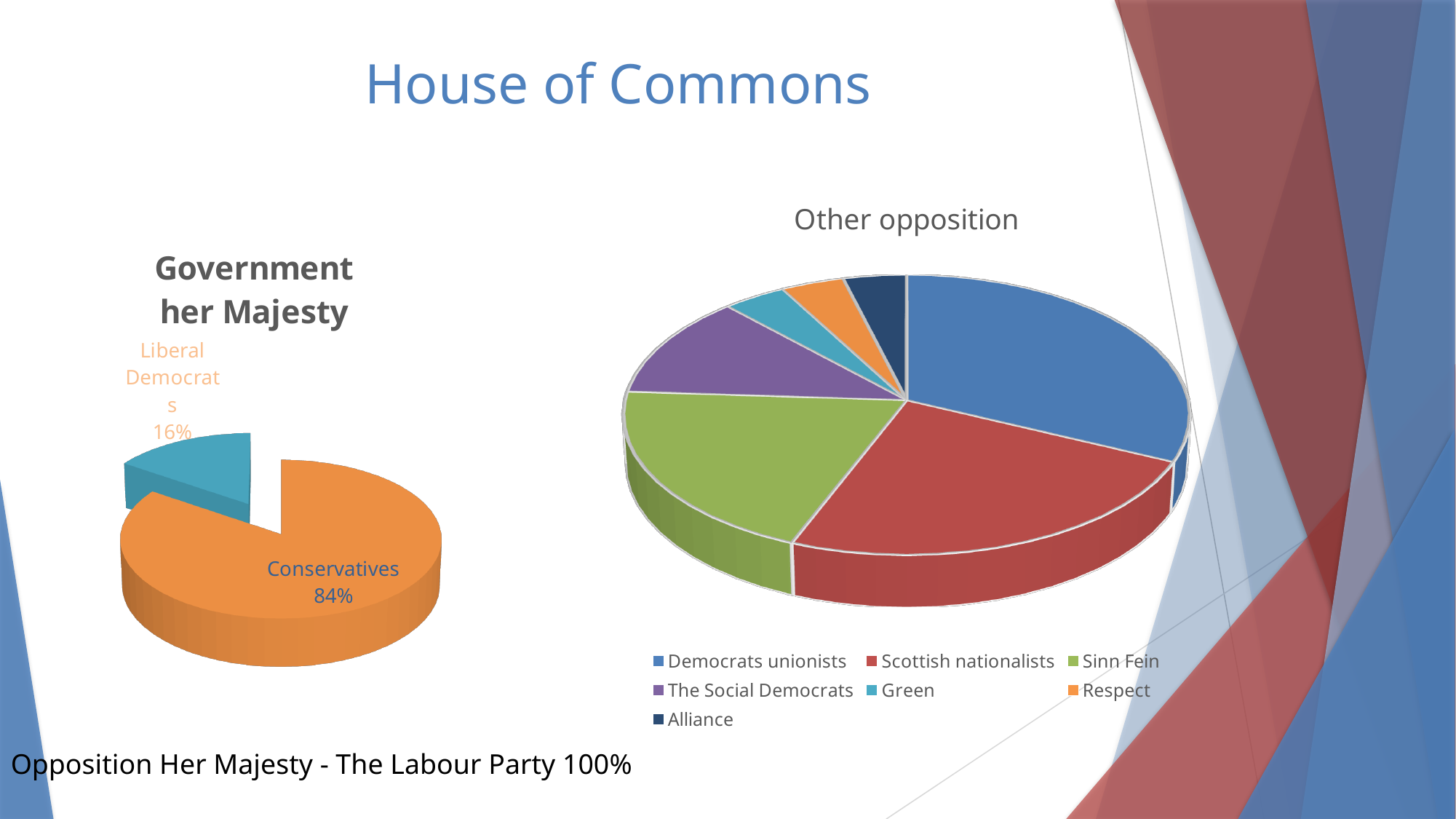
In the Other opposition pie chart, which party has the largest slice? Democrats unionists In the Government her Majesty pie chart, what percentage is shown for Conservatives? 84% In the Other opposition pie chart, which slice is larger: Scottish nationalists or Green? Scottish nationalists In the Government her Majesty pie chart, by how many percentage points does the Conservatives share exceed the Liberal Democrats share? 68 percentage points What type of chart is the Other opposition chart? Pie chart How many slices does the Government her Majesty pie chart have? 2 In the Government her Majesty pie chart, what percentage is shown for Liberal Democrats? 16% What is the title of the pie chart on the right side of the slide? Other opposition In the Government her Majesty pie chart, which party has the largest share? Conservatives How many parties are listed in the legend of the Other opposition chart? 7 In the Government her Majesty pie chart, which party has the smallest share? Liberal Democrats In the Other opposition pie chart, which slice is larger: Sinn Fein or The Social Democrats? Sinn Fein